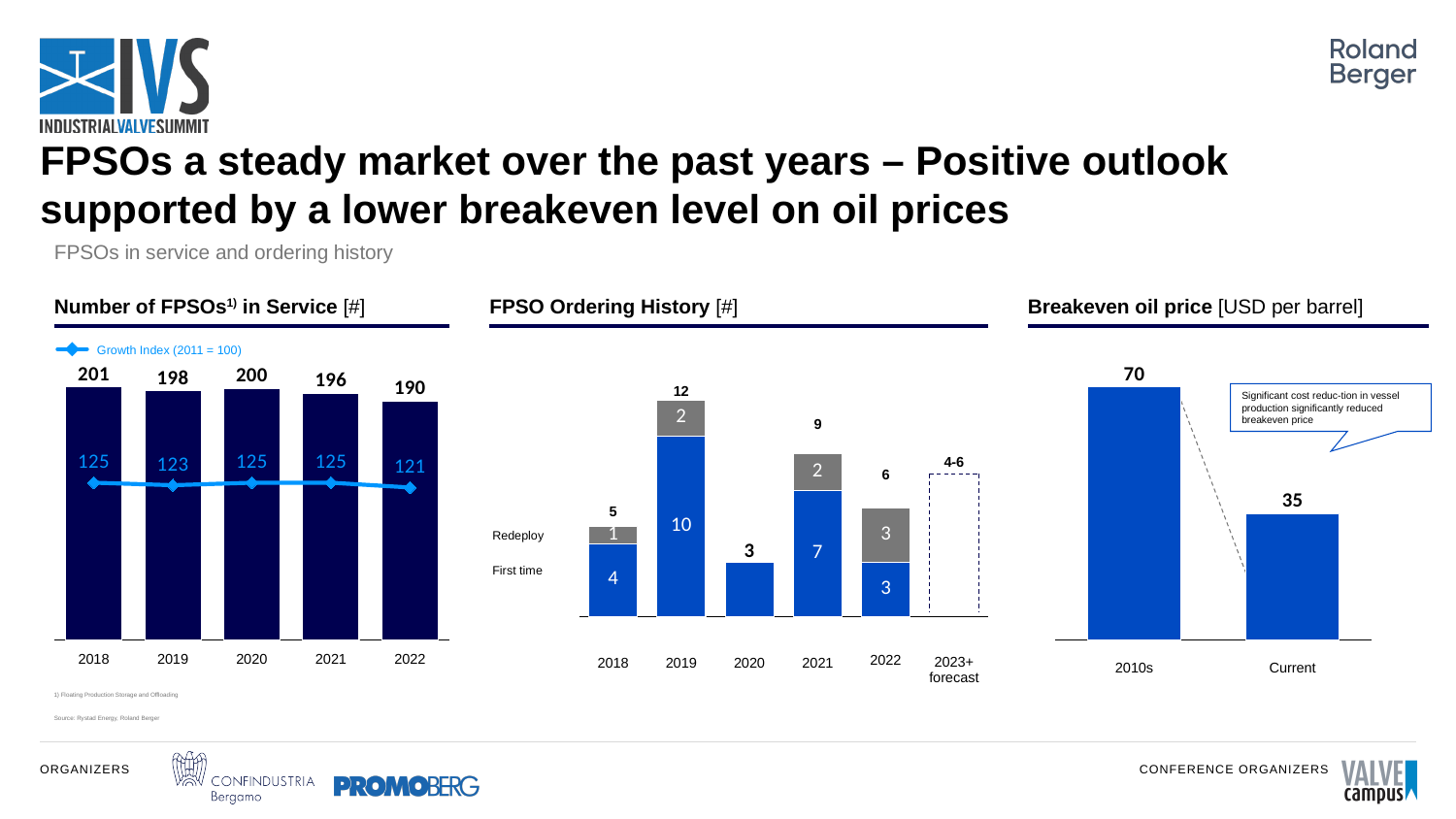
In the 'Number of FPSOs in Service' chart, how many FPSOs were in service in 2022? 190 In the 'Breakeven oil price' chart, what is the breakeven oil price for the 2010s? 70 In the 'FPSO Ordering History' chart, how many first-time orders were there in 2021? 7 In the 'FPSO Ordering History' chart, what is the forecast range of orders for 2023+? 4-6 In the 'Number of FPSOs in Service' chart, what is the Growth Index value for 2019? 123 In the 'FPSO Ordering History' chart, what is the total number of FPSOs ordered in 2019? 12 What kind of chart is the 'Breakeven oil price' chart? Bar chart In the 'Breakeven oil price' chart, what is the difference between the 2010s and Current breakeven oil prices? 35 In the 'FPSO Ordering History' chart, which year has the lowest total number of orders? 2020 In the 'Number of FPSOs in Service' chart, what is the difference between the number of FPSOs in service in 2018 and in 2022? 11 In the 'Number of FPSOs in Service' chart, which year has the highest number of FPSOs in service? 2018 In the 'FPSO Ordering History' chart, how many redeploy orders were there in 2022? 3